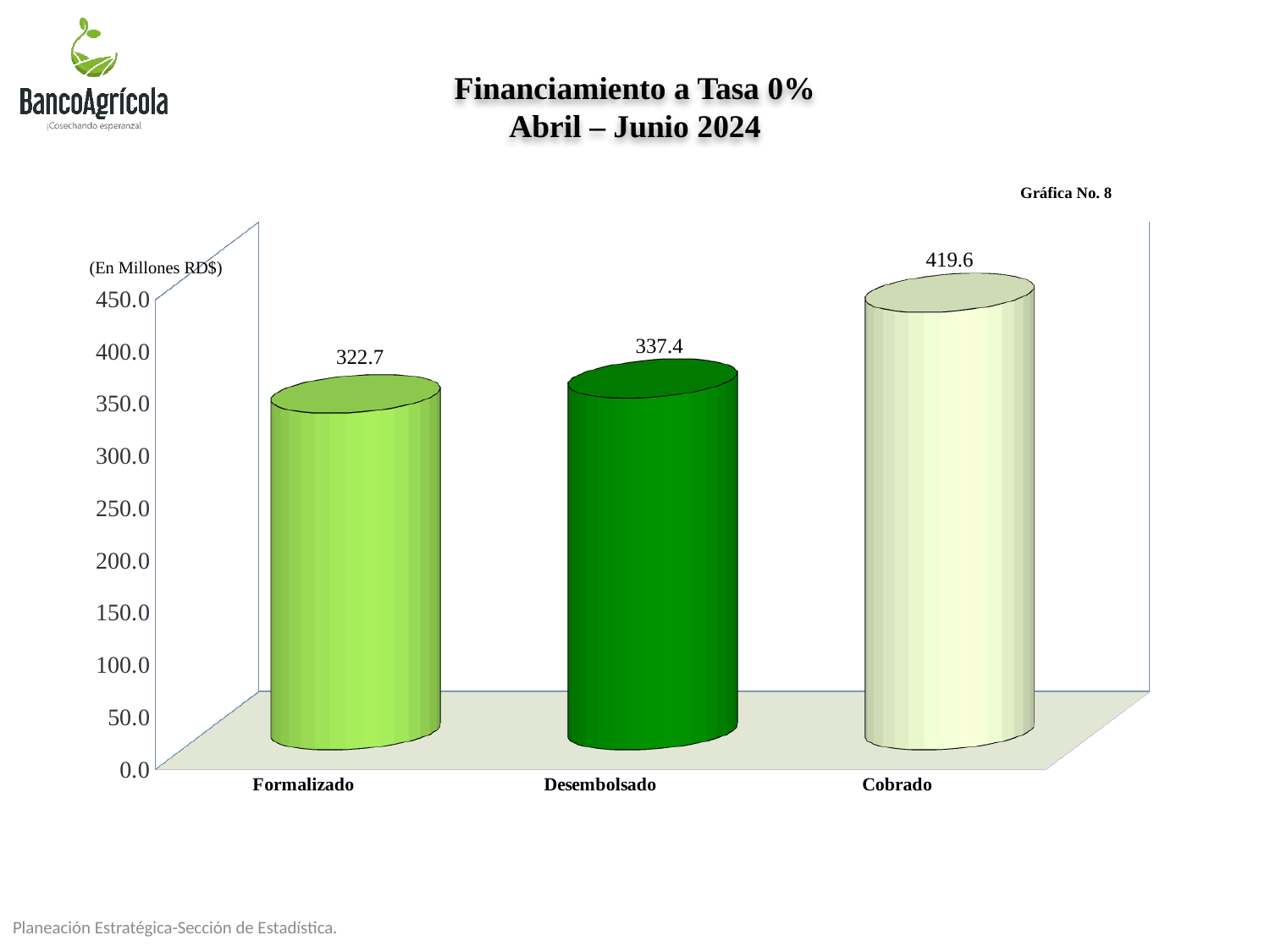
Is the value for Cobrado greater or less than 400.0? greater What is the value for Formalizado? 322.7 What kind of chart is shown on the slide? bar chart What is the difference between the values for Desembolsado and Formalizado? 14.7 What is the value for Desembolsado? 337.4 What is the title of the chart? Financiamiento a Tasa 0% Abril – Junio 2024 What is the value for Cobrado? 419.6 Which is larger, the value for Cobrado or the value for Desembolsado? Cobrado Which category has the lowest value? Formalizado What is the difference between the values for Cobrado and Formalizado? 96.9 How many categories are shown on the chart? 3 Which category has the highest value? Cobrado